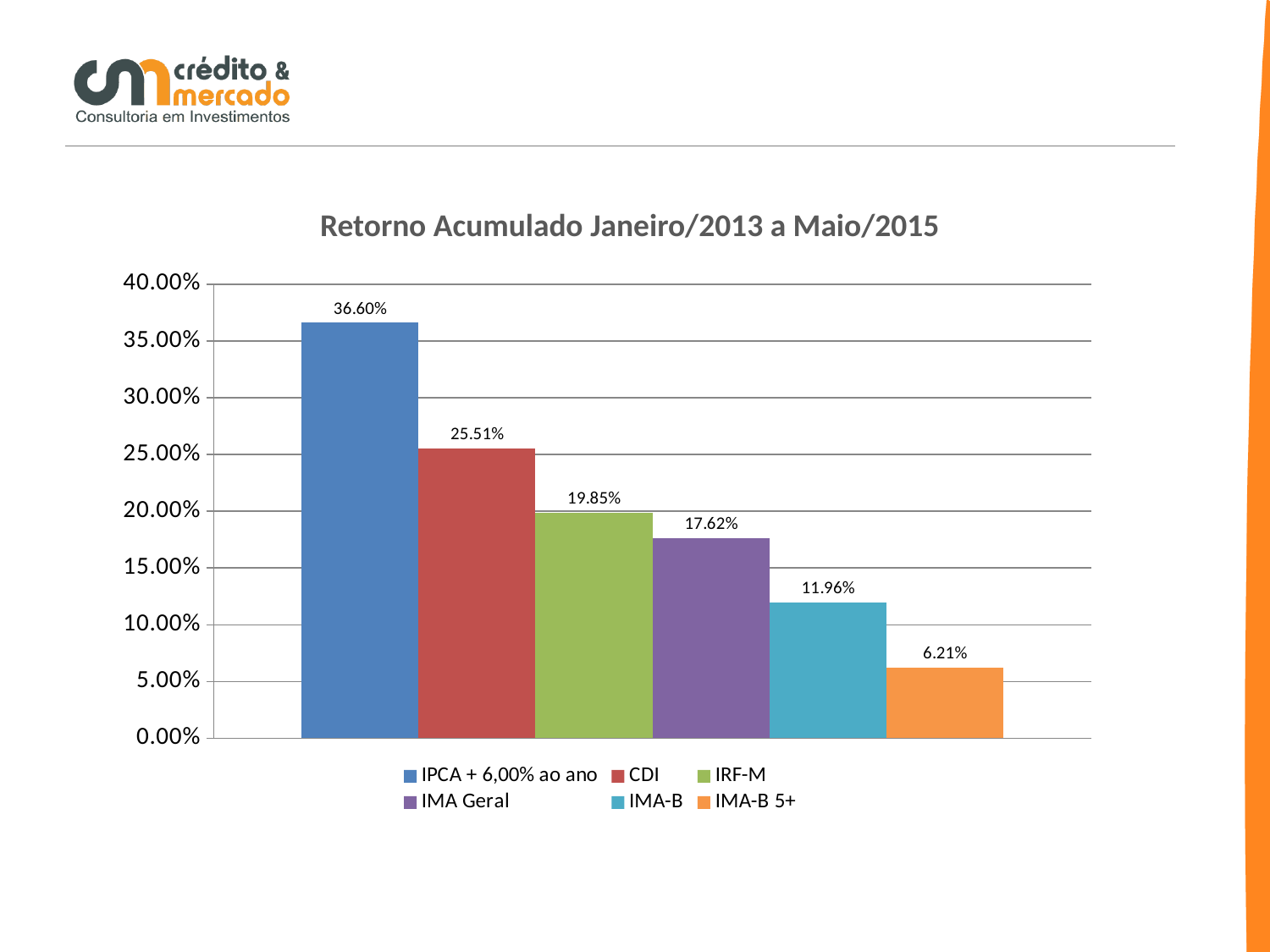
Which series has the highest value? IPCA + 6,00% ao ano What is the value for IRF-M? 19.85% Which series has the lowest value? IMA-B 5+ What is the title of the chart? Retorno Acumulado Janeiro/2013 a Maio/2015 Which is larger, the value for IRF-M or the value for IMA Geral? IRF-M How many series does the legend list? 6 What is the value for IMA-B 5+? 6.21% What is the difference between the values for IPCA + 6,00% ao ano and CDI? 11.09% Is the value for IMA-B greater or less than 10.00%? greater What kind of chart is shown on the slide? bar chart What is the value for CDI? 25.51% What is the difference between the values for IMA Geral and IMA-B? 5.66%